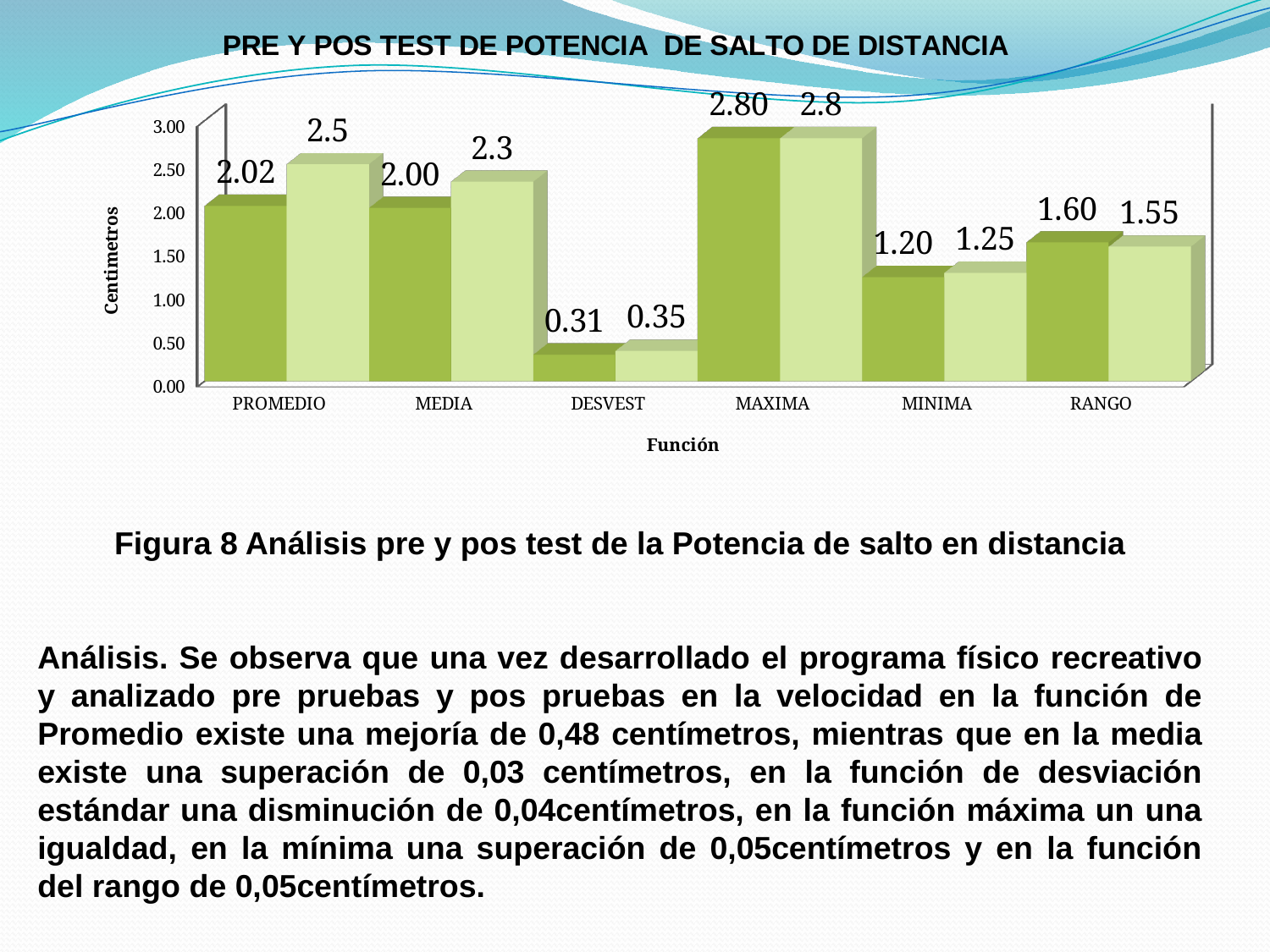
What is the value of the lighter green bar for PROMEDIO? 2.5 For RANGO, which bar is larger, the darker green bar or the lighter green bar? the darker green bar What is the value of the darker green bar for MINIMA? 1.20 Which category has the lowest values in the chart? DESVEST What is the label of the y axis? Centímetros What is the difference between the lighter green bar and the darker green bar for PROMEDIO? 0.48 What is the value of the lighter green bar for DESVEST? 0.35 What is the value of the darker green bar for PROMEDIO? 2.02 What kind of chart is shown on the slide? bar chart Which category has the highest values in the chart? MAXIMA What is the label of the x axis? Función How many categories are shown on the x axis? 6